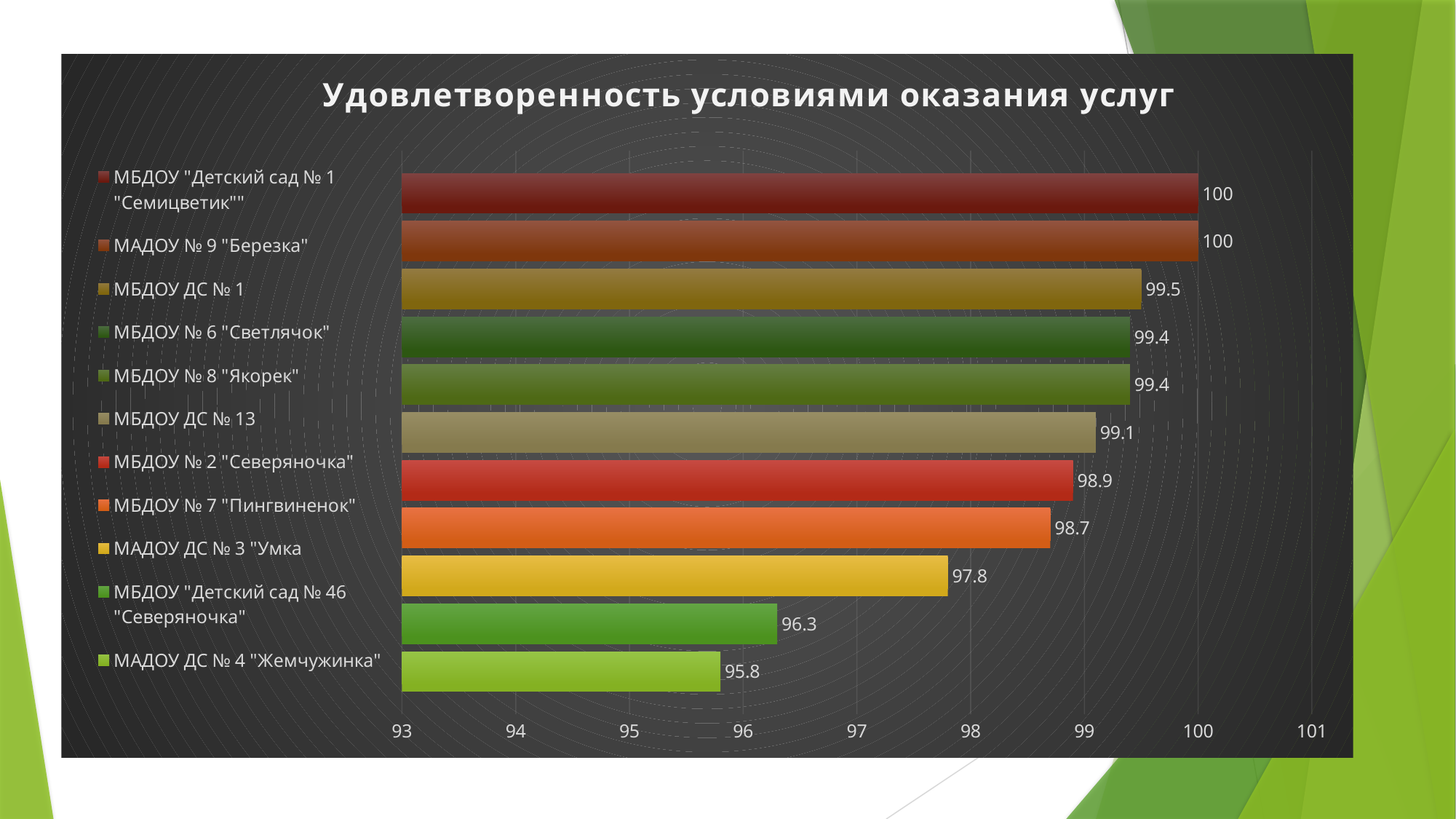
What kind of chart is shown on the slide? bar chart Is the value for МБДОУ № 6 "Светлячок" greater or less than 98? greater What is the difference between the values for МБДОУ ДС № 13 and МБДОУ "Детский сад № 46 "Северяночка"? 2.8 What is the difference between the values for МАДОУ № 9 "Березка" and МАДОУ ДС № 3 "Умка"? 2.2 What is the value for МБДОУ № 7 "Пингвиненок"? 98.7 What is the value for МБДОУ ДС № 1? 99.5 Which category has the lowest value? МАДОУ ДС № 4 "Жемчужинка" Which is larger, the value for МБДОУ № 2 "Северяночка" or the value for МБДОУ "Детский сад № 46 "Северяночка"? МБДОУ № 2 "Северяночка" What is the value for МАДОУ ДС № 3 "Умка"? 97.8 What is the value for МАДОУ ДС № 4 "Жемчужинка"? 95.8 How many categories are shown in the chart? 11 What is the title of the chart? Удовлетворенность условиями оказания услуг